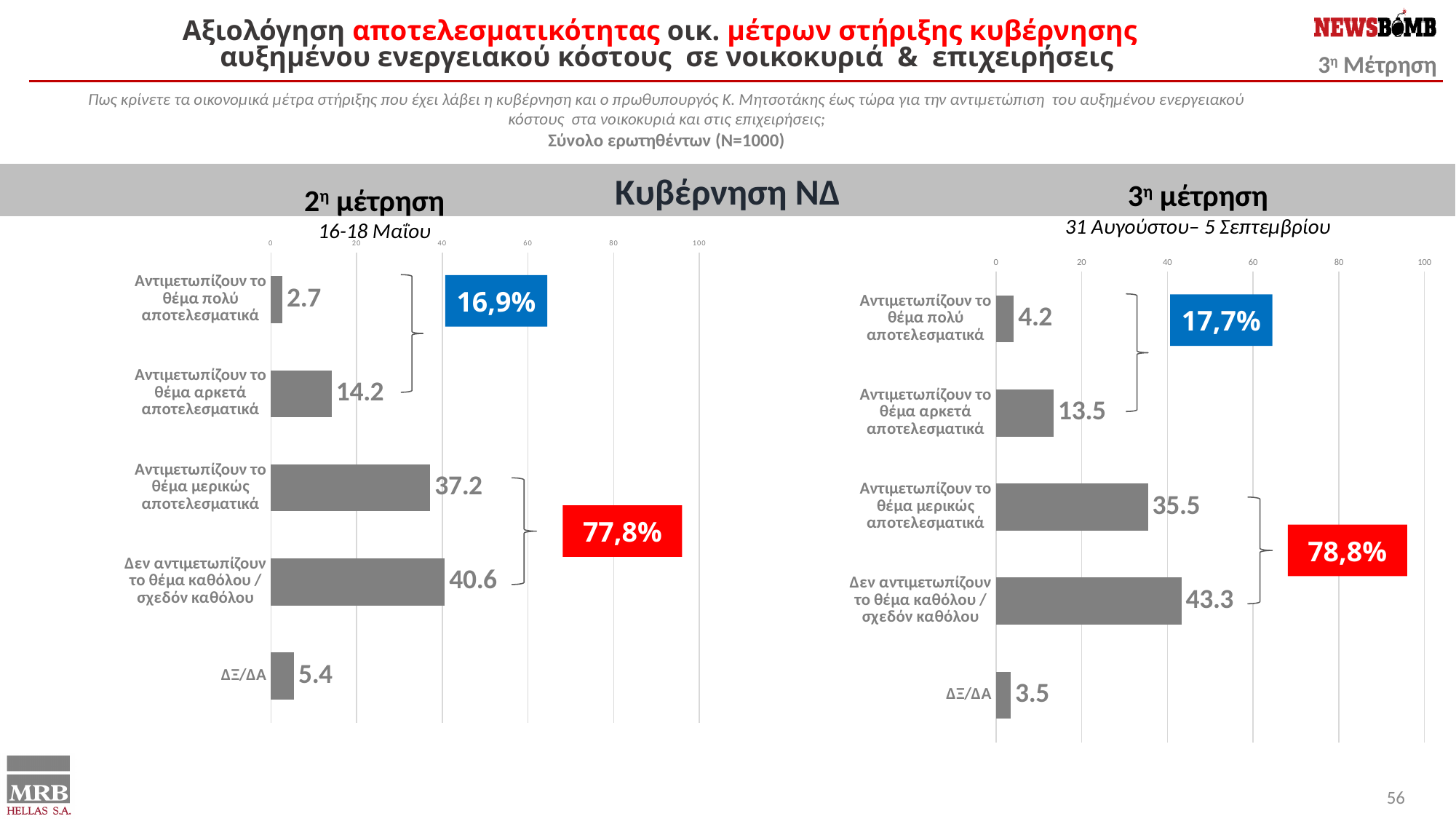
In the left chart (2η μέτρηση), which is larger: "Αντιμετωπίζουν το θέμα αρκετά αποτελεσματικά" or "ΔΞ/ΔΑ"? Αντιμετωπίζουν το θέμα αρκετά αποτελεσματικά In the left chart (2η μέτρηση), which category has the highest value? Δεν αντιμετωπίζουν το θέμα καθόλου / σχεδόν καθόλου In the left chart (2η μέτρηση), which category has the lowest value? Αντιμετωπίζουν το θέμα πολύ αποτελεσματικά In the right chart (3η μέτρηση), is the value for "Αντιμετωπίζουν το θέμα μερικώς αποτελεσματικά" greater or less than 40? less In the right chart (3η μέτρηση), what is the difference between "Δεν αντιμετωπίζουν το θέμα καθόλου / σχεδόν καθόλου" and "Αντιμετωπίζουν το θέμα μερικώς αποτελεσματικά"? 7.8 In the right chart (3η μέτρηση), what is the value for "Αντιμετωπίζουν το θέμα αρκετά αποτελεσματικά"? 13.5 How many categories are shown in the left chart (2η μέτρηση)? 5 In the right chart (3η μέτρηση), which category has the lowest value? ΔΞ/ΔΑ In the left chart (2η μέτρηση), what is the value for "Αντιμετωπίζουν το θέμα πολύ αποτελεσματικά"? 2.7 In the right chart (3η μέτρηση), what is the value for "Δεν αντιμετωπίζουν το θέμα καθόλου / σχεδόν καθόλου"? 43.3 In the right chart (3η μέτρηση), what combined percentage is shown in the red box? 78,8% What kind of chart is the right chart (3η μέτρηση)? bar chart